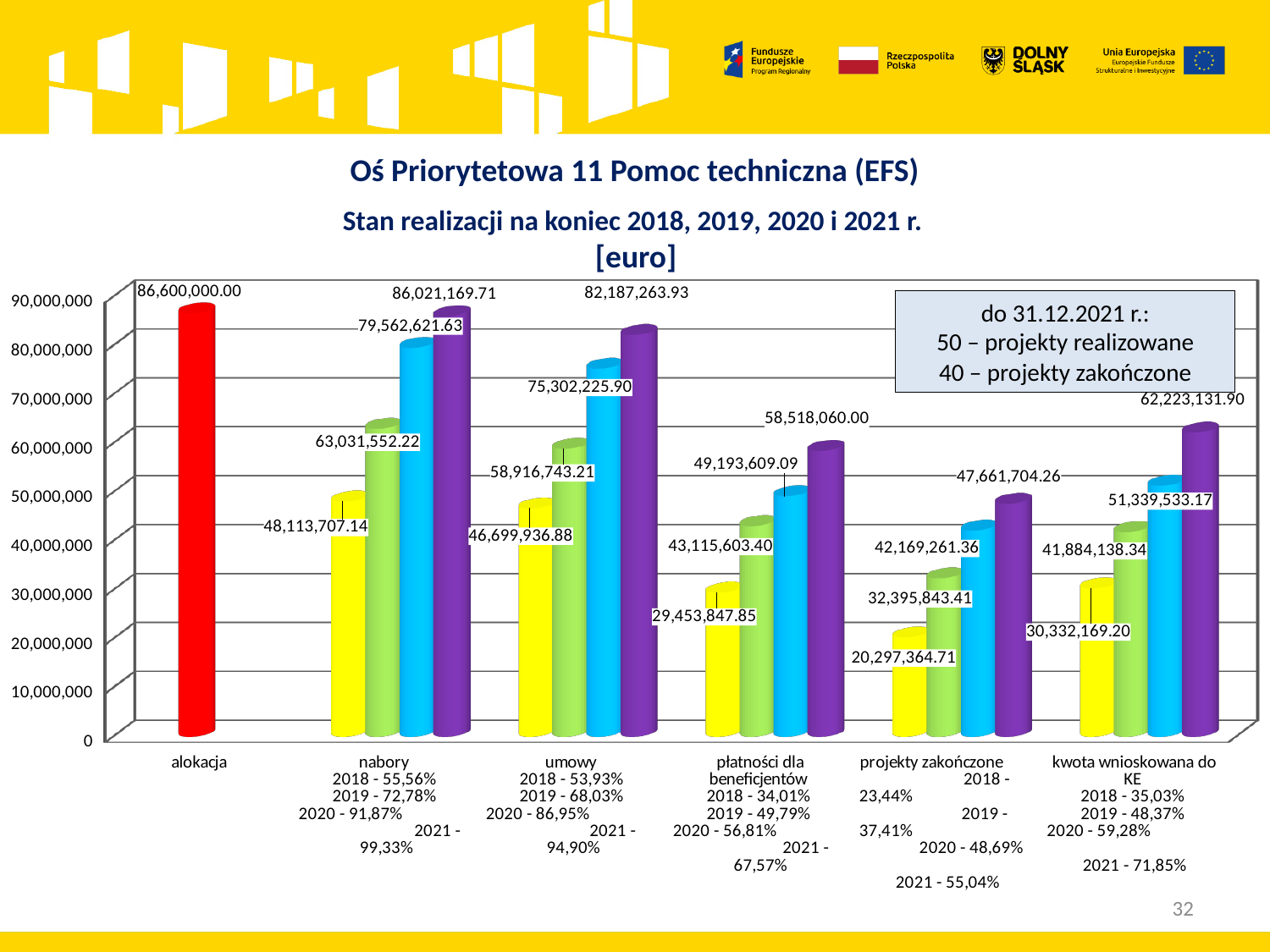
What is the value of the tallest (purple) bar in the nabory group? 86,021,169.71 What is the value of the yellow bar in the projekty zakończone group? 20,297,364.71 What is the lowest value shown on the chart? 20,297,364.71 What is the value of the shortest (yellow) bar in the umowy group? 46,699,936.88 How many categories are shown on the x axis? 6 Which is larger: the purple bar in umowy or the purple bar in nabory? nabory What type of chart is shown on the slide? bar chart What is the value of the purple bar in the płatności dla beneficjentów group? 58,518,060.00 What is the value of the purple bar in the kwota wnioskowana do KE group? 62,223,131.90 What is the value of the alokacja bar? 86,600,000.00 Which category has the single highest bar on the chart? alokacja What is the difference between the alokacja value and the tallest bar in the nabory group? 578,830.29